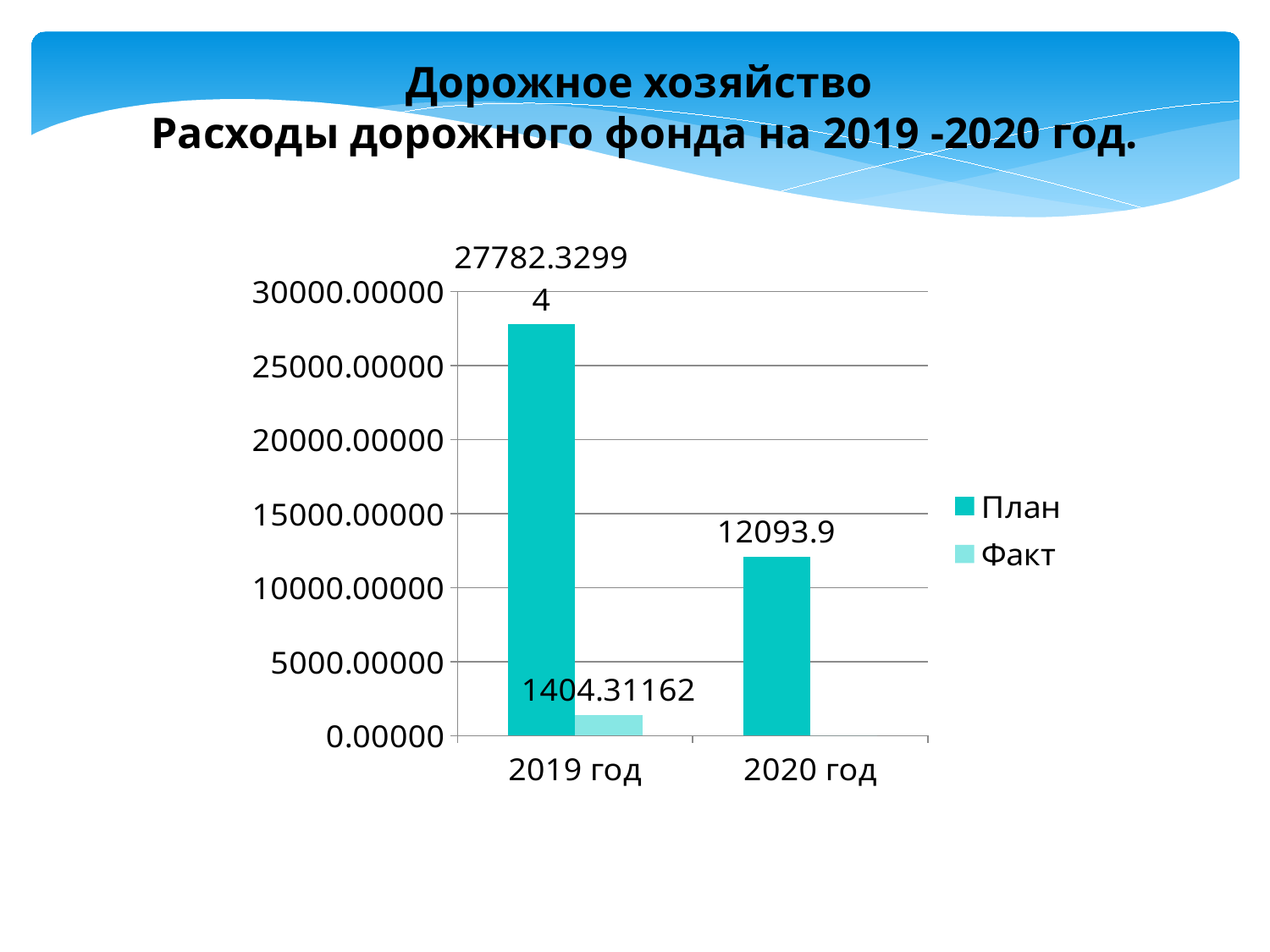
How many series does the legend list? 2 What is the План value for 2020 год? 12093.9 How many categories are shown on the x axis? 2 What kind of chart is shown on the slide? bar chart Which year has the higher План value? 2019 год Which bar on the chart is the lowest? Факт for 2019 год Does the План value rise or fall from 2019 год to 2020 год? fall What is the difference between План and Факт for 2019 год? 26378.01832 What is the difference between the План values for 2019 год and 2020 год? 15688.42994 What is the Факт value for 2019 год? 1404.31162 What is the План value for 2019 год? 27782.32994 Is the План value for 2020 год greater or less than 15000.00000? less